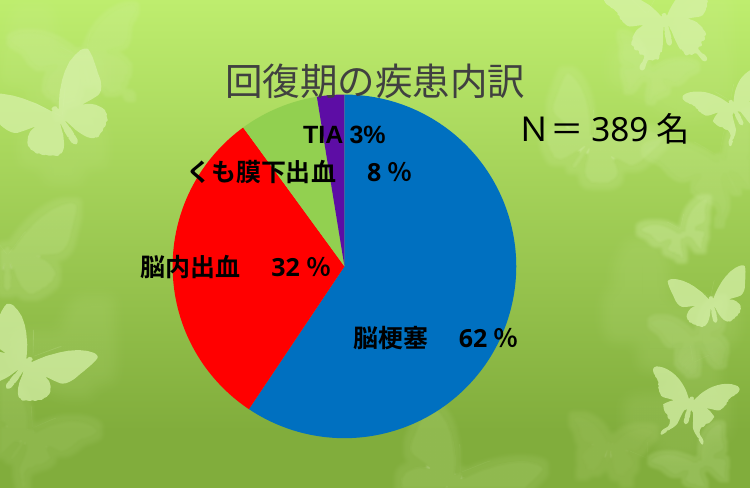
Which category has the smallest slice of the pie? TIA What percentage of the pie is TIA? 3% What percentage of the pie is 脳梗塞? 62% What percentage of the pie is くも膜下出血? 8% What is the title of the chart? 回復期の疾患内訳 What is the difference in percentage points between 脳梗塞 and 脳内出血? 30 How many slices does the pie chart have? 4 Which is larger, the share for くも膜下出血 or the share for TIA? くも膜下出血 Which category has the largest slice of the pie? 脳梗塞 What is the total number of cases (N) stated on the slide? 389名 What kind of chart is shown on the slide? pie chart